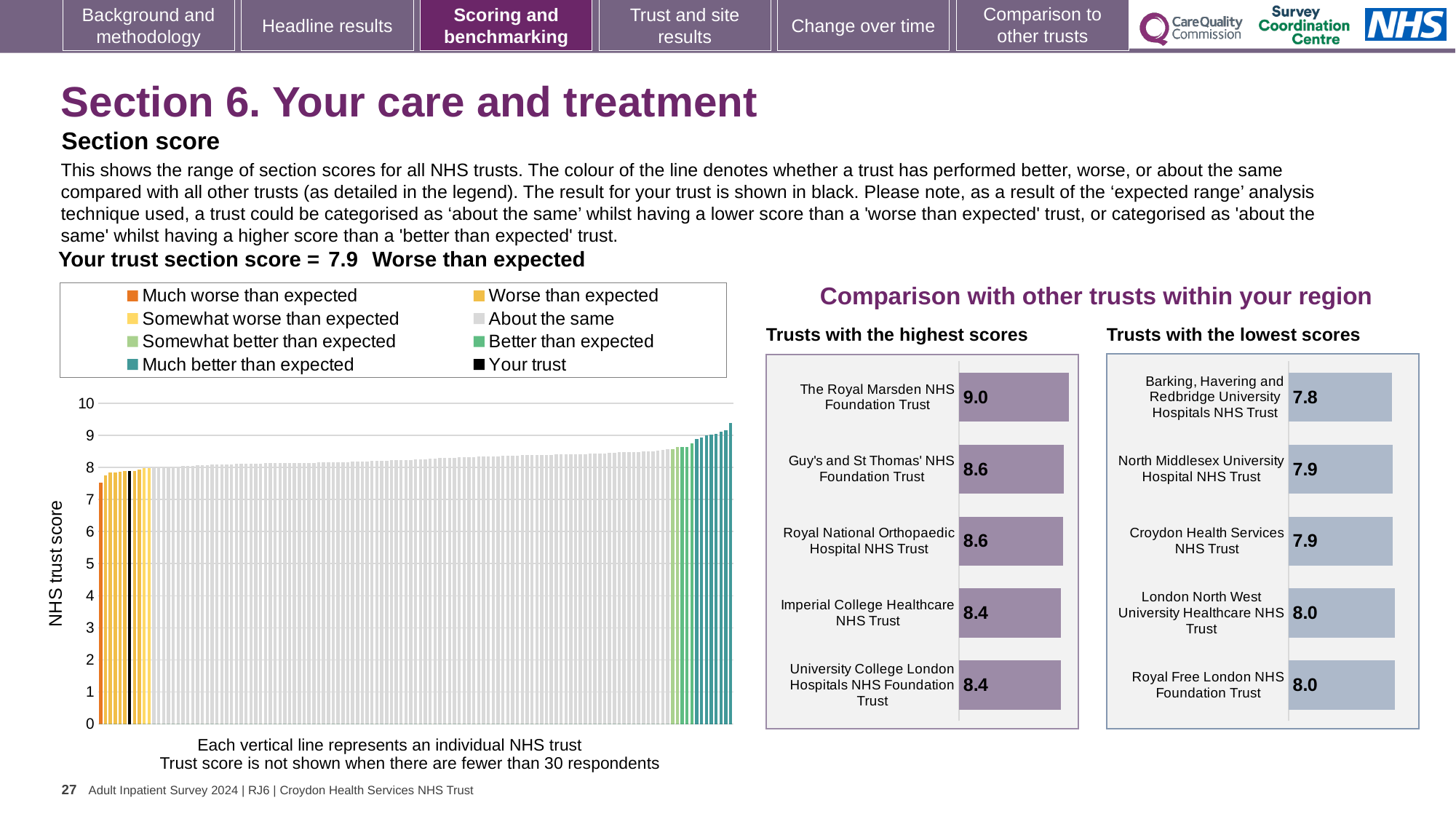
How many entries does the legend of the NHS trust score chart on the left list? 8 In the 'NHS trust score' chart on the left, is the value of the rightmost (tallest) bar greater or less than 9? greater According to the slide, what is your trust's section score for Section 6? 7.9 How many trusts are shown in the 'Trusts with the highest scores' chart? 5 In the 'Trusts with the highest scores' chart, what is the score for The Royal Marsden NHS Foundation Trust? 9.0 In the 'Trusts with the lowest scores' chart, which trust has the lowest score? Barking, Havering and Redbridge University Hospitals NHS Trust What kind of chart is the 'NHS trust score' chart on the left of the slide? Bar chart In the 'Trusts with the highest scores' chart, which trust has the highest score? The Royal Marsden NHS Foundation Trust In the 'NHS trust score' chart on the left, do the bar values rise or fall from left to right? Rise In the 'Trusts with the lowest scores' chart, which has the larger score: Royal Free London NHS Foundation Trust or Barking, Havering and Redbridge University Hospitals NHS Trust? Royal Free London NHS Foundation Trust In the 'Trusts with the lowest scores' chart, what is the score for Barking, Havering and Redbridge University Hospitals NHS Trust? 7.8 In the 'Trusts with the highest scores' chart, what is the difference between the scores of The Royal Marsden NHS Foundation Trust and Imperial College Healthcare NHS Trust? 0.6